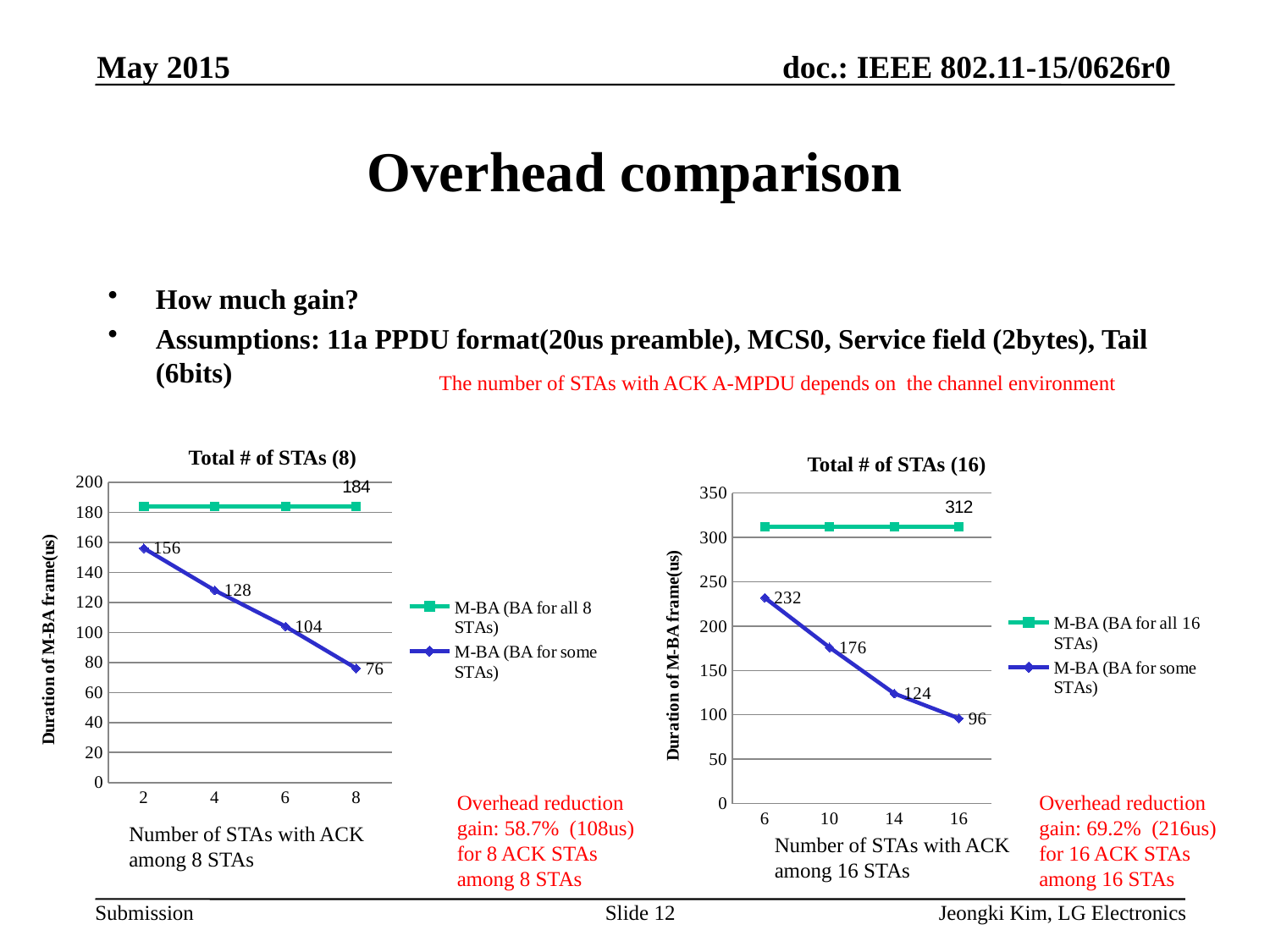
In the 'Total # of STAs (16)' chart, what is the difference between the 'M-BA (BA for some STAs)' values at 6 and 14 STAs with ACK? 108 How many series does the legend of the 'Total # of STAs (16)' chart list? 2 What kind of chart is the 'Total # of STAs (8)' chart? Line chart In the 'Total # of STAs (8)' chart, what is the value of 'M-BA (BA for some STAs)' when the number of STAs with ACK is 4? 128 In the 'Total # of STAs (8)' chart, what is the value of 'M-BA (BA for some STAs)' when the number of STAs with ACK is 8? 76 In the 'Total # of STAs (16)' chart, what value is labelled on the 'M-BA (BA for all 16 STAs)' line? 312 In the 'Total # of STAs (16)' chart, which is larger: 'M-BA (BA for some STAs)' at 6 STAs with ACK or at 16 STAs with ACK? 6 STAs with ACK In the 'Total # of STAs (16)' chart, what is the value of 'M-BA (BA for some STAs)' when the number of STAs with ACK is 10? 176 In the 'Total # of STAs (16)' chart, at which number of STAs with ACK is 'M-BA (BA for some STAs)' lowest? 16 In the 'Total # of STAs (8)' chart, at which number of STAs with ACK is 'M-BA (BA for some STAs)' highest? 2 In the 'Total # of STAs (8)' chart, how does 'M-BA (BA for some STAs)' change as the number of STAs with ACK increases? It falls In the 'Total # of STAs (8)' chart, what is the difference between the 'M-BA (BA for all 8 STAs)' value (184) and the 'M-BA (BA for some STAs)' value at 8 STAs with ACK? 108